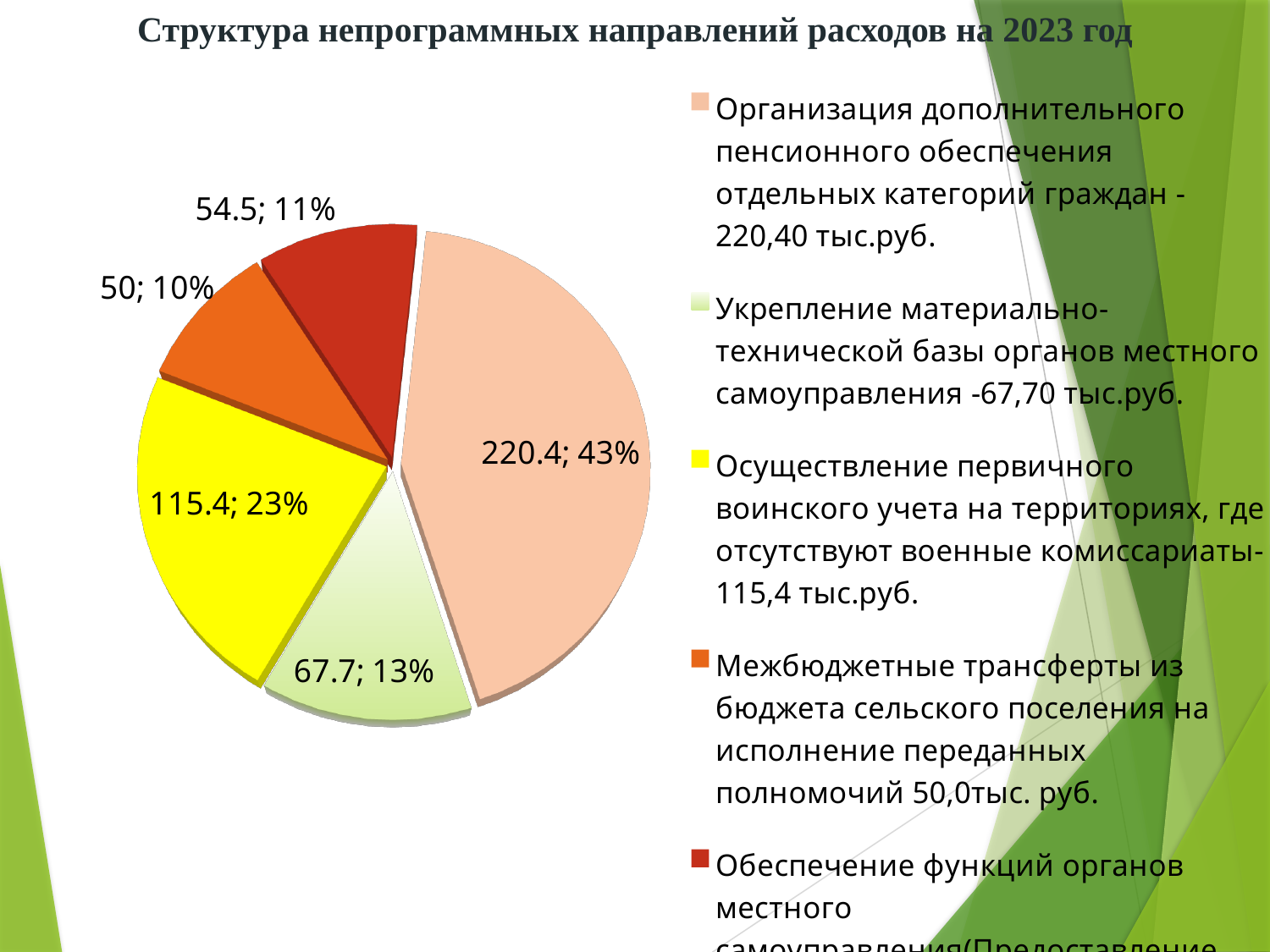
What is the difference between the value for 'Организация дополнительного пенсионного обеспечения' (220.4) and the value for 'Осуществление первичного воинского учета' (115.4)? 105 What share of the pie does 'Межбюджетные трансферты из бюджета сельского поселения на исполнение переданных полномочий' take? 10% What value is shown for the slice 'Осуществление первичного воинского учета на территориях, где отсутствуют военные комиссариаты'? 115.4 What value is shown for the slice 'Укрепление материально-технической базы органов местного самоуправления'? 67.7 What is the difference between the value for 'Укрепление материально-технической базы' (67.7) and the value for 'Обеспечение функций органов местного самоуправления' (54.5)? 13.2 Which category has the largest slice in the pie chart? Организация дополнительного пенсионного обеспечения отдельных категорий граждан How many slices does the pie chart have? 5 What kind of chart is shown on the slide? pie chart Which is larger: the slice for 'Обеспечение функций органов местного самоуправления' or the slice for 'Межбюджетные трансферты из бюджета сельского поселения'? Обеспечение функций органов местного самоуправления What is the title of the chart on the slide? Структура непрограммных направлений расходов на 2023 год What share of the pie does 'Организация дополнительного пенсионного обеспечения отдельных категорий граждан' take? 43% Which category has the smallest slice in the pie chart? Межбюджетные трансферты из бюджета сельского поселения на исполнение переданных полномочий